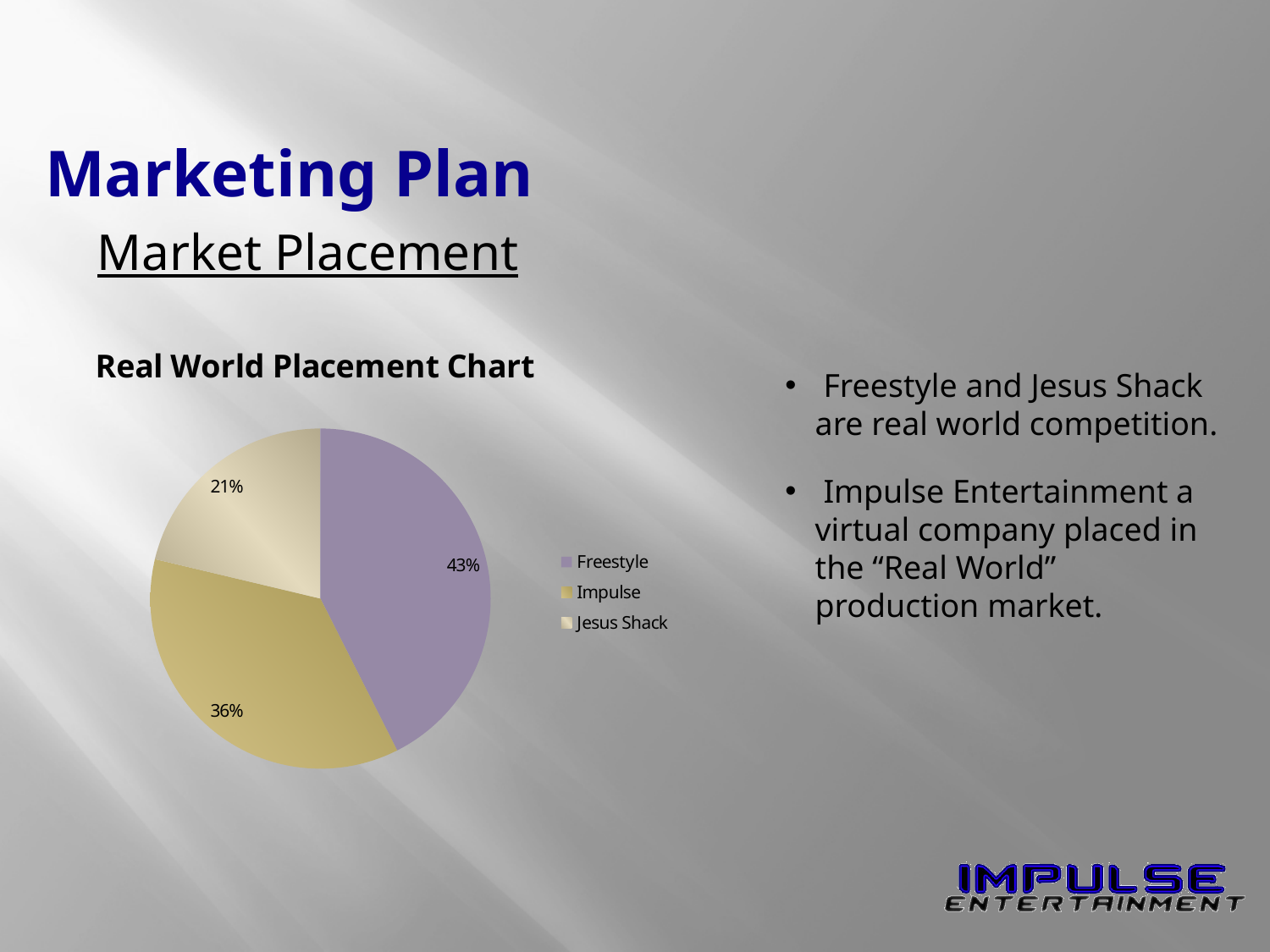
What kind of chart is shown on the slide? Pie chart How many slices does the pie chart have? 3 What share of the pie does Impulse hold? 36% Which category has the smallest slice of the pie? Jesus Shack Which category has the largest slice of the pie? Freestyle Which is larger, the share for Impulse or the share for Jesus Shack? Impulse What share of the pie does Freestyle hold? 43% What share of the pie does Jesus Shack hold? 21% What is the difference in percentage points between Impulse and Jesus Shack? 15 Which category is shown in purple in the legend? Freestyle What is the title of the chart? Real World Placement Chart What is the difference in percentage points between Freestyle and Impulse? 7